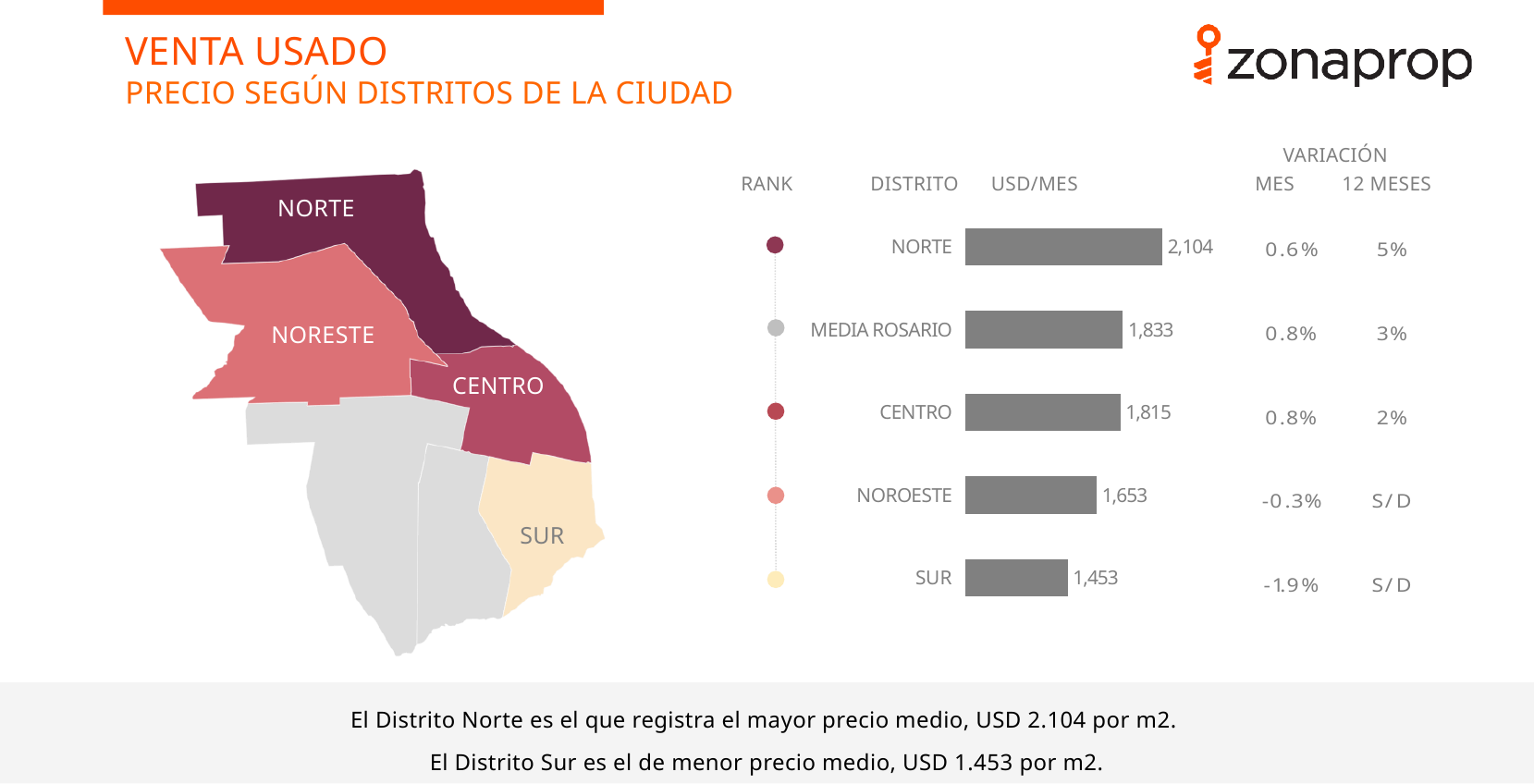
What is the difference in USD/MES between MEDIA ROSARIO and CENTRO? 18 What is the USD/MES value for NORTE in the bar chart? 2,104 What kind of chart is used to show the USD/MES values? Bar chart How many districts are shown in the bar chart? 5 What is the 12-month variation (12 MESES) shown for NORTE? 5% What is the USD/MES value for MEDIA ROSARIO in the bar chart? 1,833 Which has a higher USD/MES value, CENTRO or NOROESTE? CENTRO Which district has the highest USD/MES value in the bar chart? NORTE What is the USD/MES value for SUR in the bar chart? 1,453 What is the monthly variation (MES) shown for SUR? -1.9% What is the difference in USD/MES between NORTE and SUR? 651 Which district has the lowest USD/MES value in the bar chart? SUR